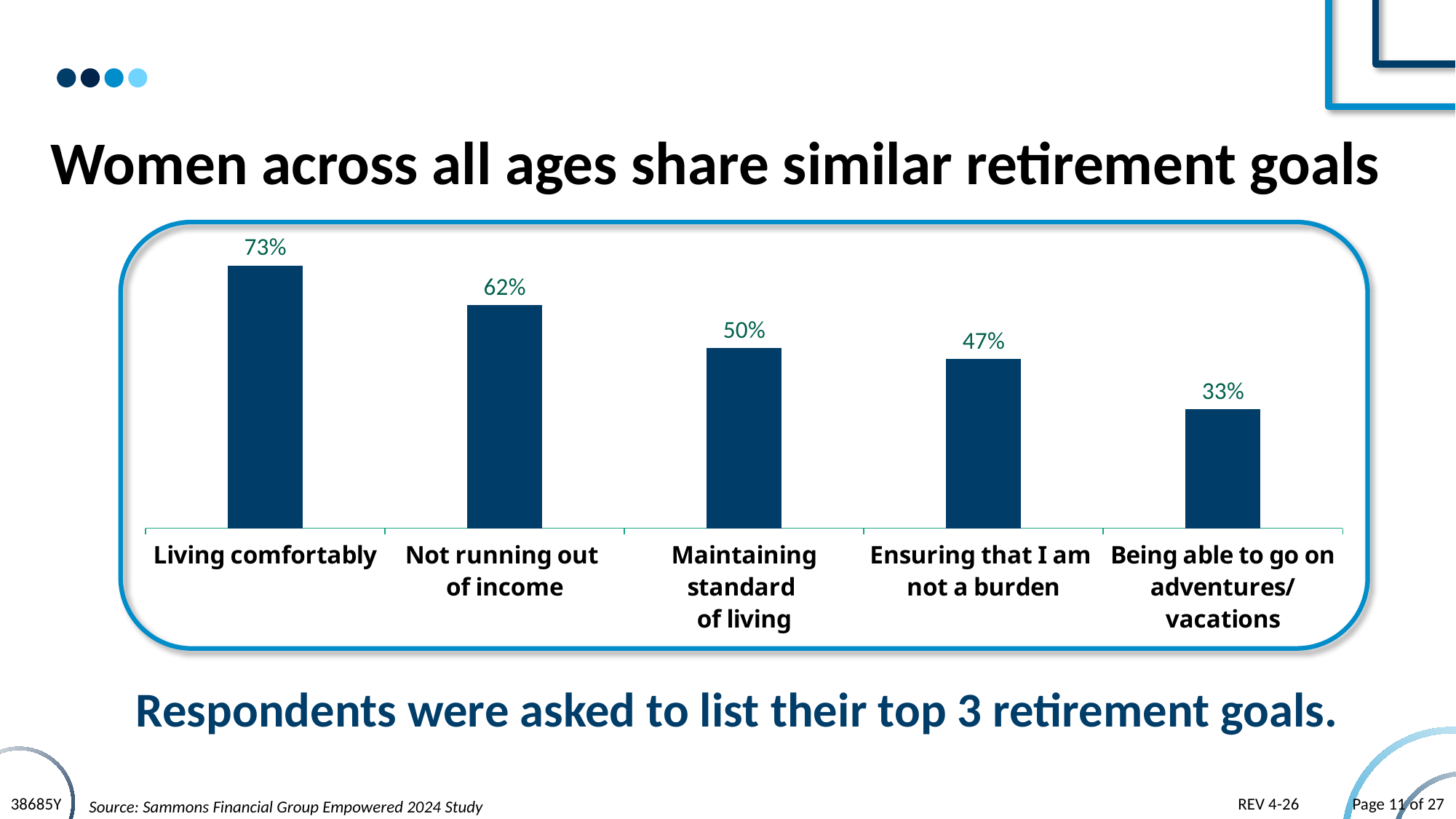
How many retirement goals are shown in the chart? 5 What is the value shown for 'Not running out of income'? 62% Which is larger: the value for 'Ensuring that I am not a burden' or the value for 'Being able to go on adventures/vacations'? Ensuring that I am not a burden Which retirement goal has the highest value? Living comfortably What is the difference between the values for 'Living comfortably' and 'Not running out of income'? 11% What is the difference between the values for 'Maintaining standard of living' and 'Ensuring that I am not a burden'? 3% What is the value shown for 'Being able to go on adventures/vacations'? 33% What percentage of respondents listed 'Living comfortably' as a retirement goal? 73% Which retirement goal has the lowest value? Being able to go on adventures/vacations Do the values rise or fall moving from left to right across the chart? Fall What kind of chart is shown on the slide? Bar chart What is the value shown for 'Maintaining standard of living'? 50%